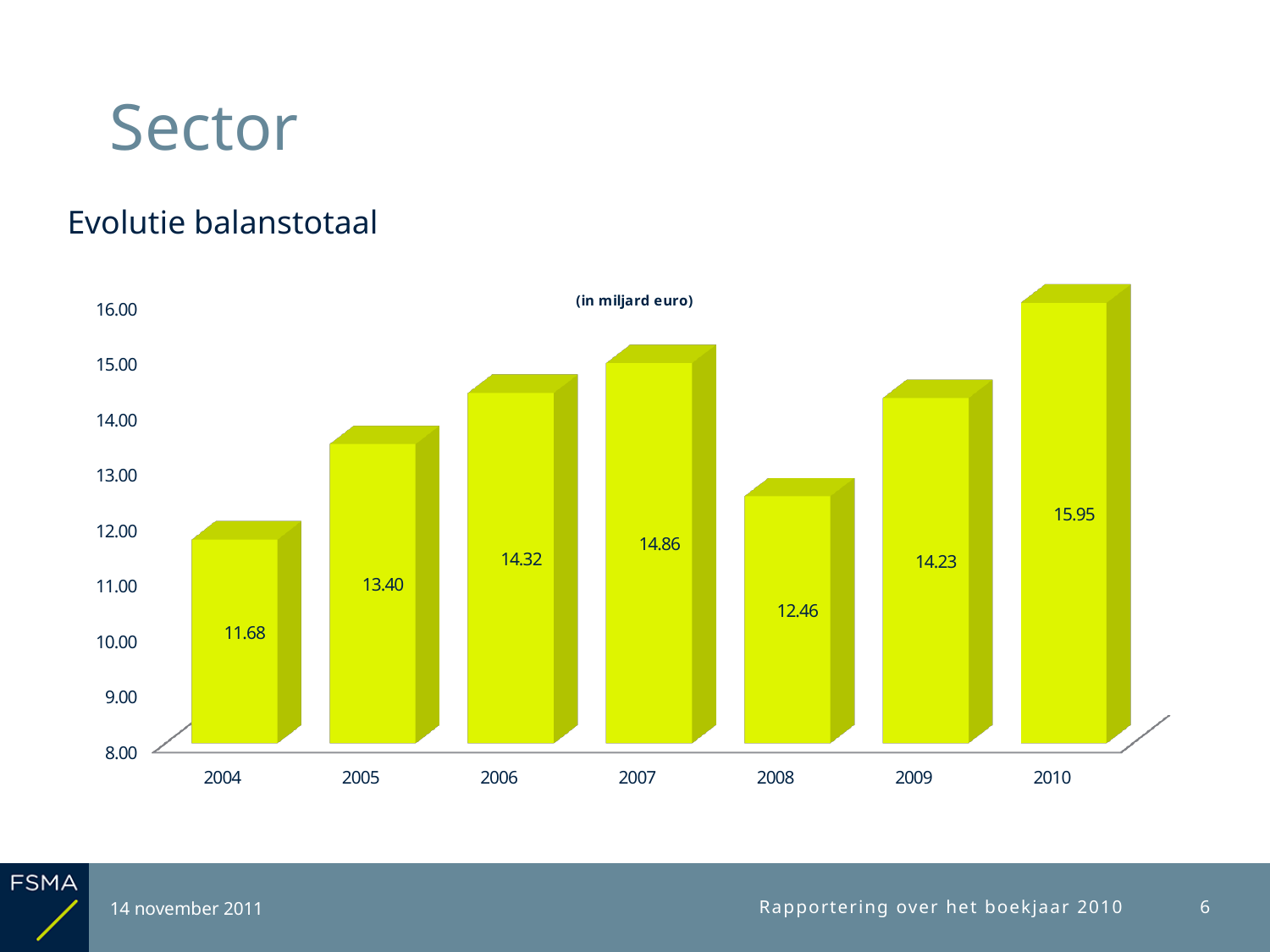
In what unit are the values expressed, according to the label above the chart? in miljard euro How many years are shown on the x axis? 7 What is the value for 2008? 12.46 Which year has the highest value? 2010 What is the difference between the values for 2010 and 2009? 1.72 What is the value for 2004? 11.68 What kind of chart is shown on the slide? bar chart Which year has the lowest value? 2004 What is the value for 2010? 15.95 Which is larger, the value for 2006 or the value for 2009? 2006 Is the value for 2005 greater or less than 13.00? greater What is the difference between the values for 2007 and 2008? 2.40